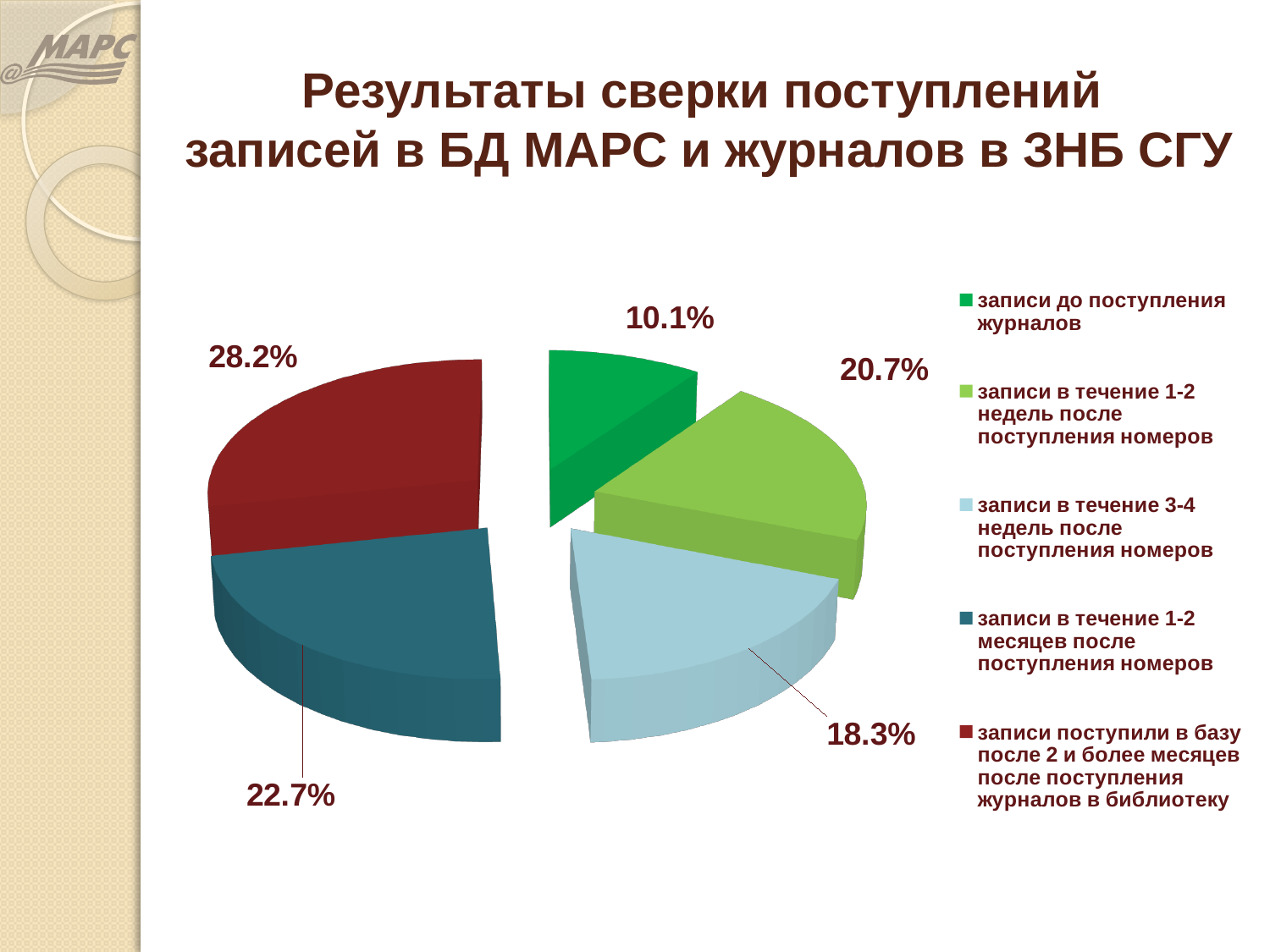
What share of the pie is labelled "записи в течение 1-2 недель после поступления номеров"? 20.7% What share of the pie is labelled "записи поступили в базу после 2 и более месяцев после поступления журналов в библиотеку"? 28.2% Which category has the largest slice of the pie? записи поступили в базу после 2 и более месяцев после поступления журналов в библиотеку What colour is the slice for "записи в течение 3-4 недель после поступления номеров"? light blue What share of the pie is labelled "записи в течение 1-2 месяцев после поступления номеров"? 22.7% What share of the pie is labelled "записи до поступления журналов"? 10.1% Which category has the smallest slice of the pie? записи до поступления журналов How many slices does the pie chart have? 5 What is the difference in percentage points between the slice for "записи в течение 1-2 месяцев после поступления номеров" and the slice for "записи до поступления журналов"? 12.6 Which slice is larger: "записи в течение 1-2 недель после поступления номеров" or "записи в течение 3-4 недель после поступления номеров"? записи в течение 1-2 недель после поступления номеров What kind of chart is shown on the slide? pie chart What share of the pie is labelled "записи в течение 3-4 недель после поступления номеров"? 18.3%